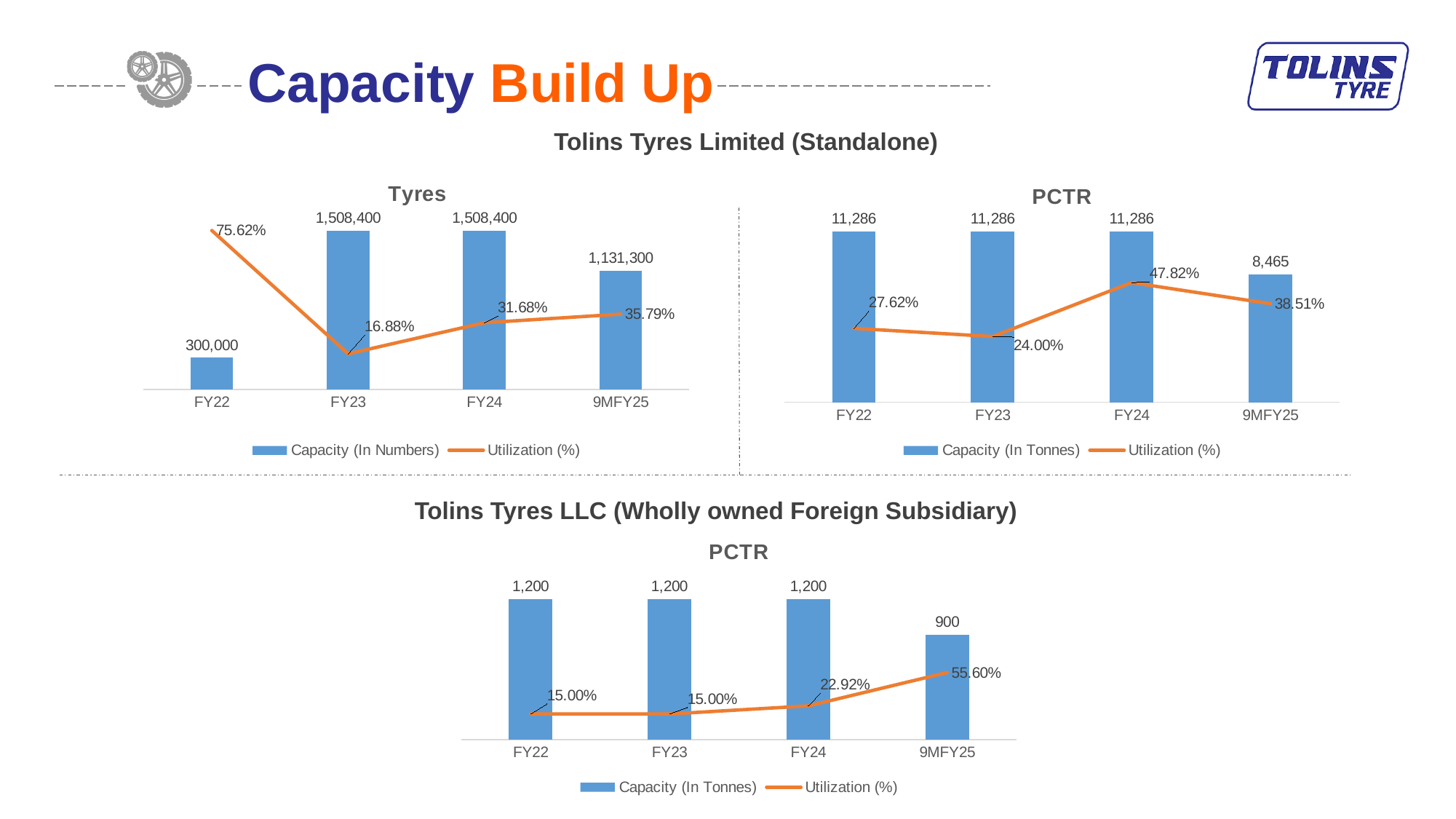
In the Standalone PCTR chart (top right), is the Utilization (%) for FY23 larger or smaller than for FY22? smaller How many series does the legend of the Tolins Tyres LLC PCTR chart (bottom) list? 2 In the Tolins Tyres LLC PCTR chart (bottom), what is the Utilization (%) for 9MFY25? 55.60% In the Standalone PCTR chart (top right), what is the Capacity (In Tonnes) for 9MFY25? 8,465 How many periods are shown on the x axis of the Tyres chart (top left)? 4 In the Tyres chart (top left), what is the difference in Capacity (In Numbers) between FY24 and 9MFY25? 377,100 In the Tolins Tyres LLC PCTR chart (bottom), does Utilization (%) rise or fall from FY23 to 9MFY25? rise In the Standalone PCTR chart (top right), which period has the highest Utilization (%)? FY24 In the Tyres chart (top left), what is the Capacity (In Numbers) for FY22? 300,000 In the Tyres chart (top left), what is the Utilization (%) for FY22? 75.62% In the Tyres chart (top left), which period has the lowest Utilization (%)? FY23 In the Tolins Tyres LLC PCTR chart (bottom), what is the Capacity (In Tonnes) for FY24? 1,200